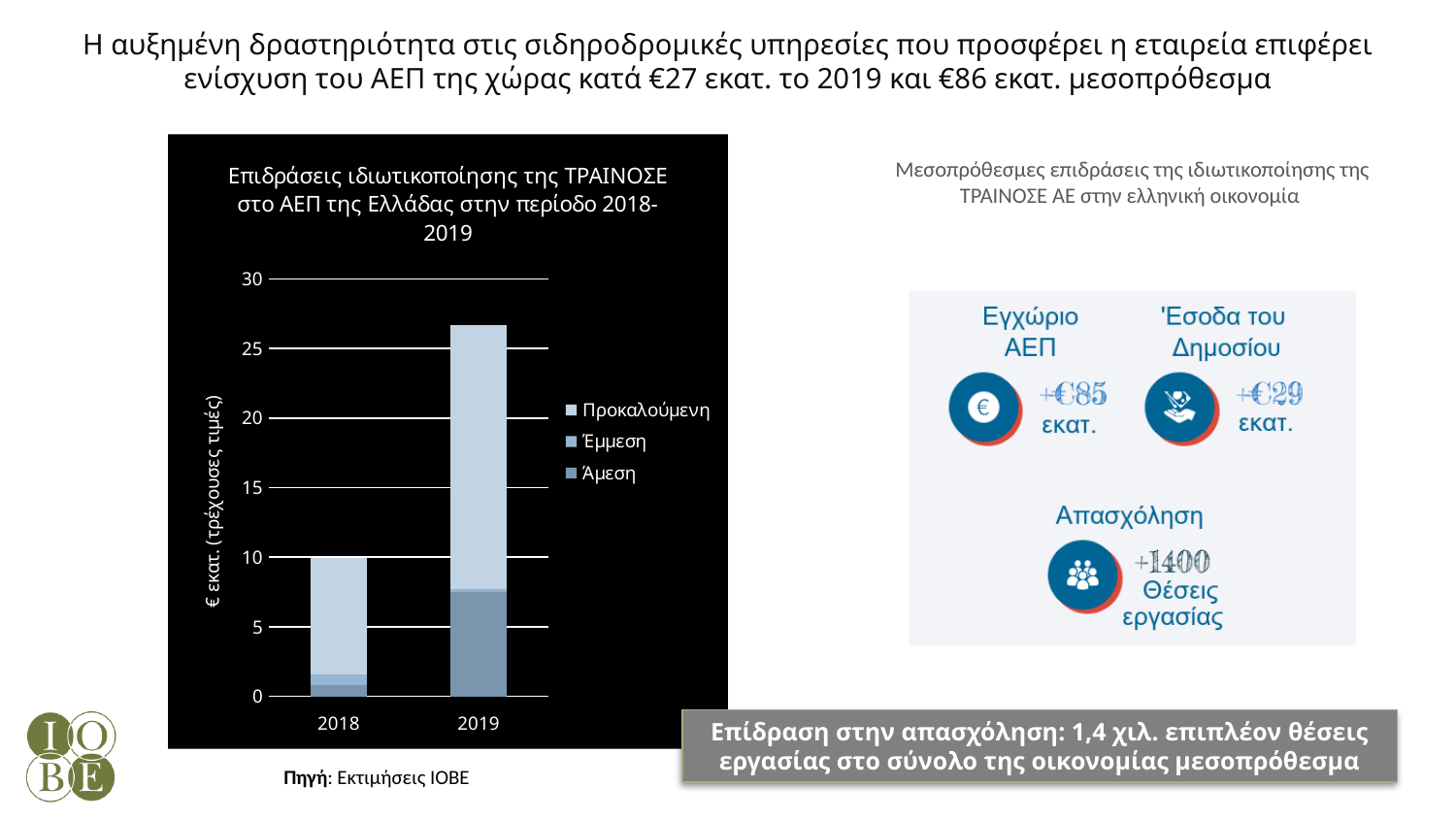
How many series does the chart's legend list? 3 What kind of chart is shown on the slide? Stacked bar chart Is the total value for 2019 greater or less than 20? greater Which year has the lower total bar in the chart? 2018 Is the Άμεση segment for 2019 greater or less than 5? greater Which year has the higher total bar in the chart? 2019 Which series accounts for the largest part of the 2019 bar? Προκαλούμενη Is the total value for 2018 greater or less than 15? less Do the total values rise or fall from 2018 to 2019? rise What is the label of the chart's y axis? € εκατ. (τρέχουσες τιμές) What is the title of the chart? Επιδράσεις ιδιωτικοποίησης της ΤΡΑΙΝΟΣΕ στο ΑΕΠ της Ελλάδας στην περίοδο 2018-2019 How many years (categories) are shown on the x axis of the chart? 2